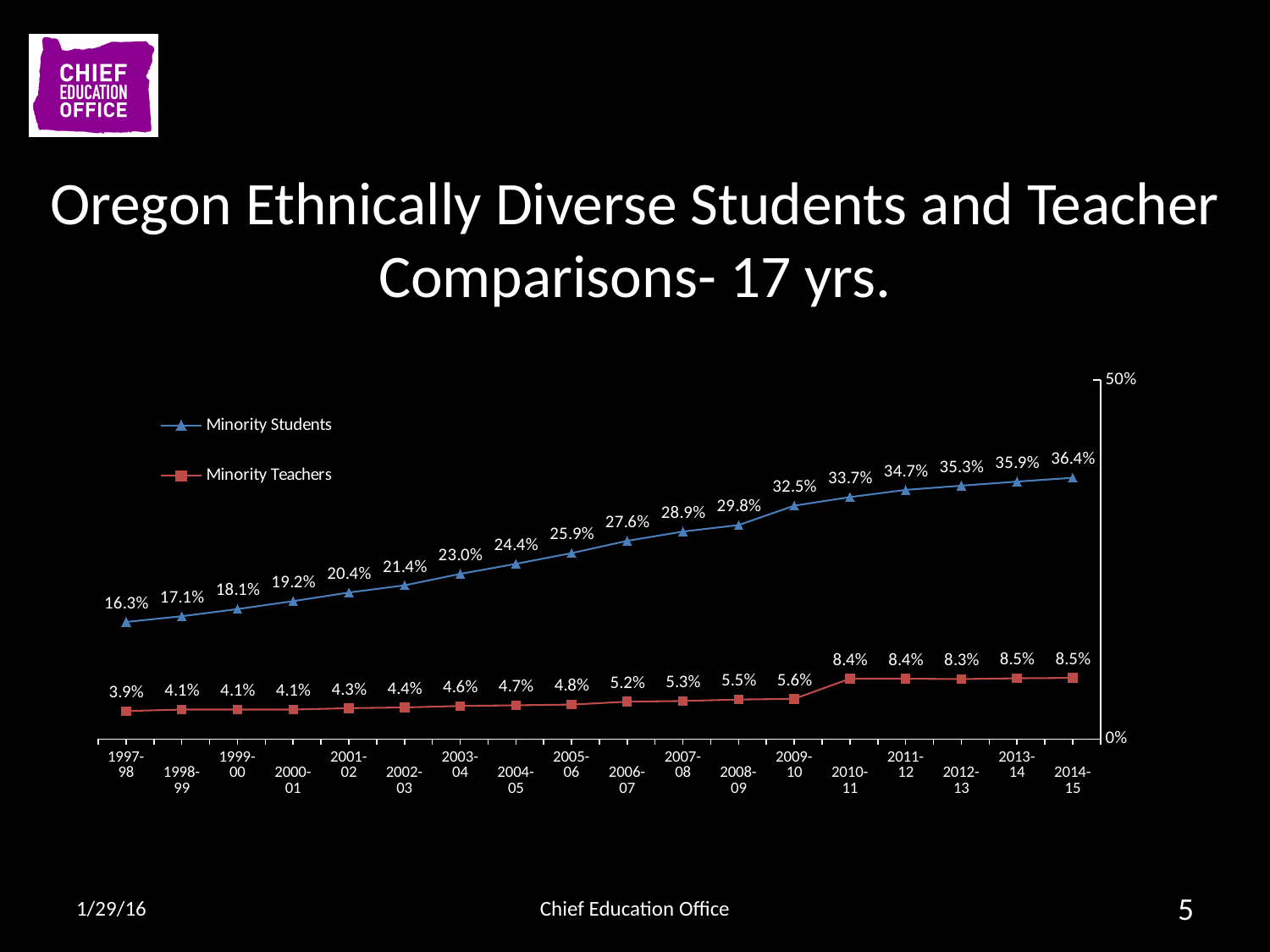
How many series does the legend list? 2 What is the value for Minority Teachers in 2010-11? 8.4% What is the value for Minority Teachers in 1997-98? 3.9% What is the value for Minority Students in 2005-06? 25.9% Which is larger in 2009-10: the Minority Students value or the Minority Teachers value? Minority Students In which school year is the Minority Students value lowest? 1997-98 What is the difference between the Minority Students and Minority Teachers values in 2014-15? 27.9% How many school years are plotted on the x axis? 18 Does the Minority Students series rise or fall from 1997-98 to 2014-15? Rise What is the difference between the Minority Students value in 2014-15 and in 1997-98? 20.1% What is the value for Minority Students in 2014-15? 36.4% What type of chart is shown on the slide? Line chart